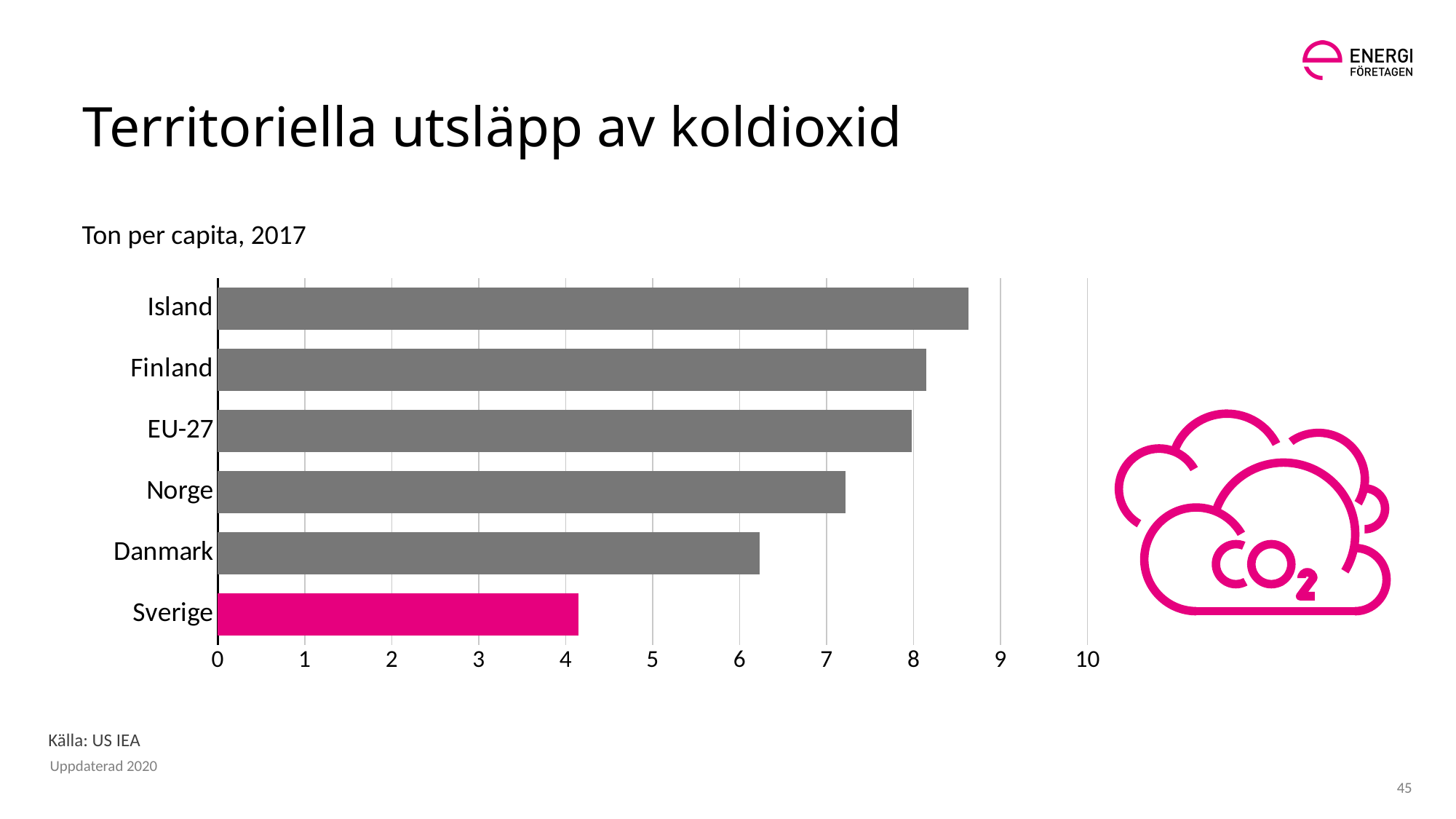
Is the value for Sverige greater or less than 5? less Is the value for Danmark greater or less than 7? less What kind of chart is shown on the slide? bar chart Which has the larger value, Danmark or Sverige? Danmark Which bar in the chart is highlighted in pink rather than grey? Sverige Is the value for EU-27 greater or less than 7? greater Which country or region has the highest territorial CO2 emissions per capita in the chart? Island Which country or region has the lowest territorial CO2 emissions per capita in the chart? Sverige Which has the larger value, Norge or Danmark? Norge How many countries or regions are shown in the chart? 6